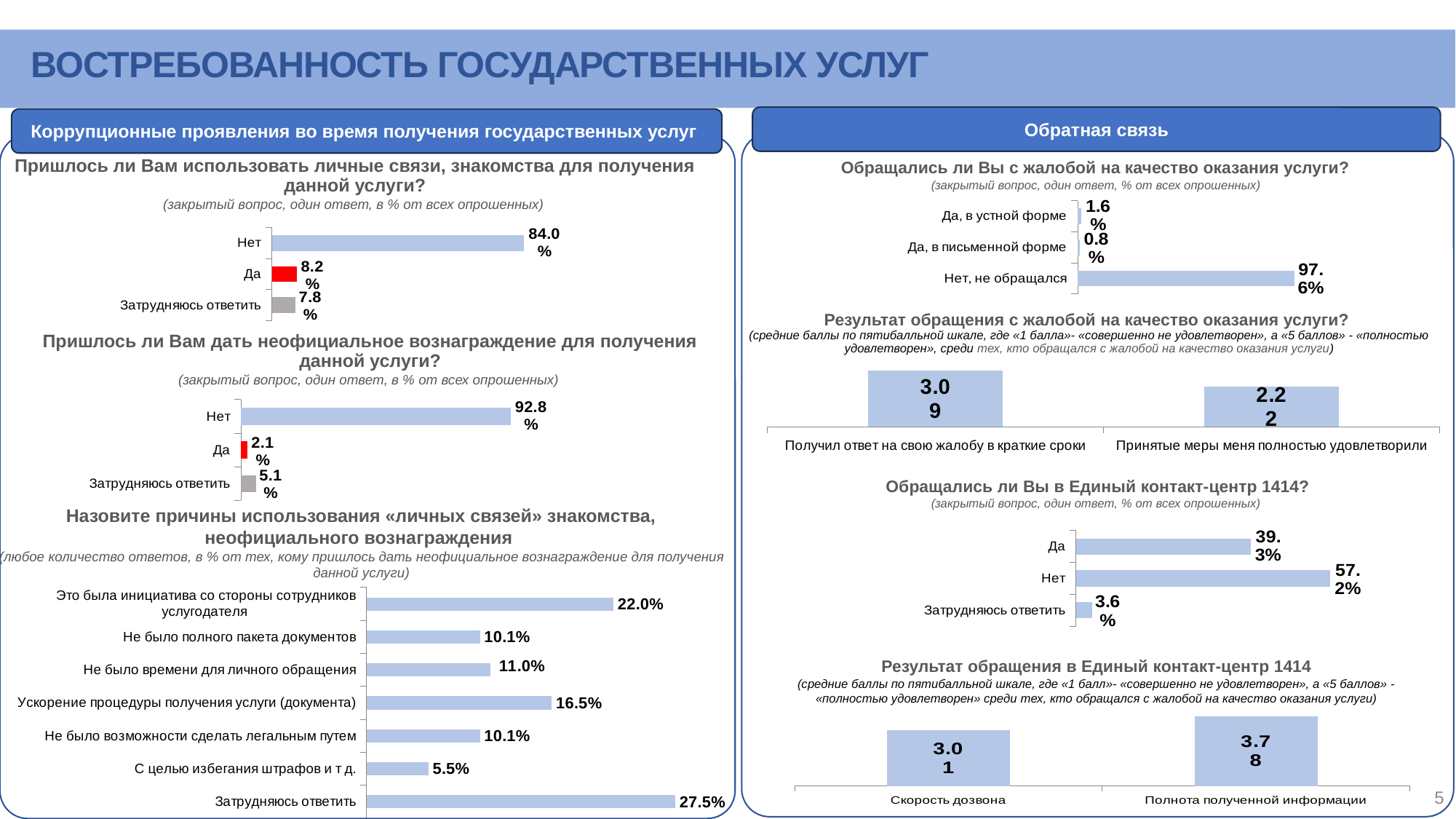
In the chart 'Пришлось ли Вам использовать личные связи, знакомства для получения данной услуги?', what is the value for 'Нет'? 84.0% In the chart 'Назовите причины использования «личных связей» знакомства, неофициального вознаграждения', how many categories are shown? 7 In the chart 'Назовите причины использования «личных связей» знакомства, неофициального вознаграждения', which category has the highest value? Затрудняюсь ответить In the chart 'Обращались ли Вы с жалобой на качество оказания услуги?', what is the value for 'Нет, не обращался'? 97.6% In the chart 'Результат обращения с жалобой на качество оказания услуги?', which is larger: 'Получил ответ на свою жалобу в краткие сроки' or 'Принятые меры меня полностью удовлетворили'? Получил ответ на свою жалобу в краткие сроки In the chart 'Результат обращения в Единый контакт-центр 1414', what is the value for 'Полнота полученной информации'? 3.78 What type of chart is 'Обращались ли Вы в Единый контакт-центр 1414?'? Bar chart In the chart 'Пришлось ли Вам использовать личные связи, знакомства для получения данной услуги?', which category has the lowest value? Затрудняюсь ответить In the chart 'Назовите причины использования «личных связей» знакомства, неофициального вознаграждения', what is the value for 'Ускорение процедуры получения услуги (документа)'? 16.5% In the chart 'Пришлось ли Вам дать неофициальное вознаграждение для получения данной услуги?', what is the difference between 'Затрудняюсь ответить' and 'Да'? 3.0% In the chart 'Обращались ли Вы в Единый контакт-центр 1414?', what is the value for 'Нет'? 57.2% In the chart 'Пришлось ли Вам дать неофициальное вознаграждение для получения данной услуги?', what is the value for 'Да'? 2.1%